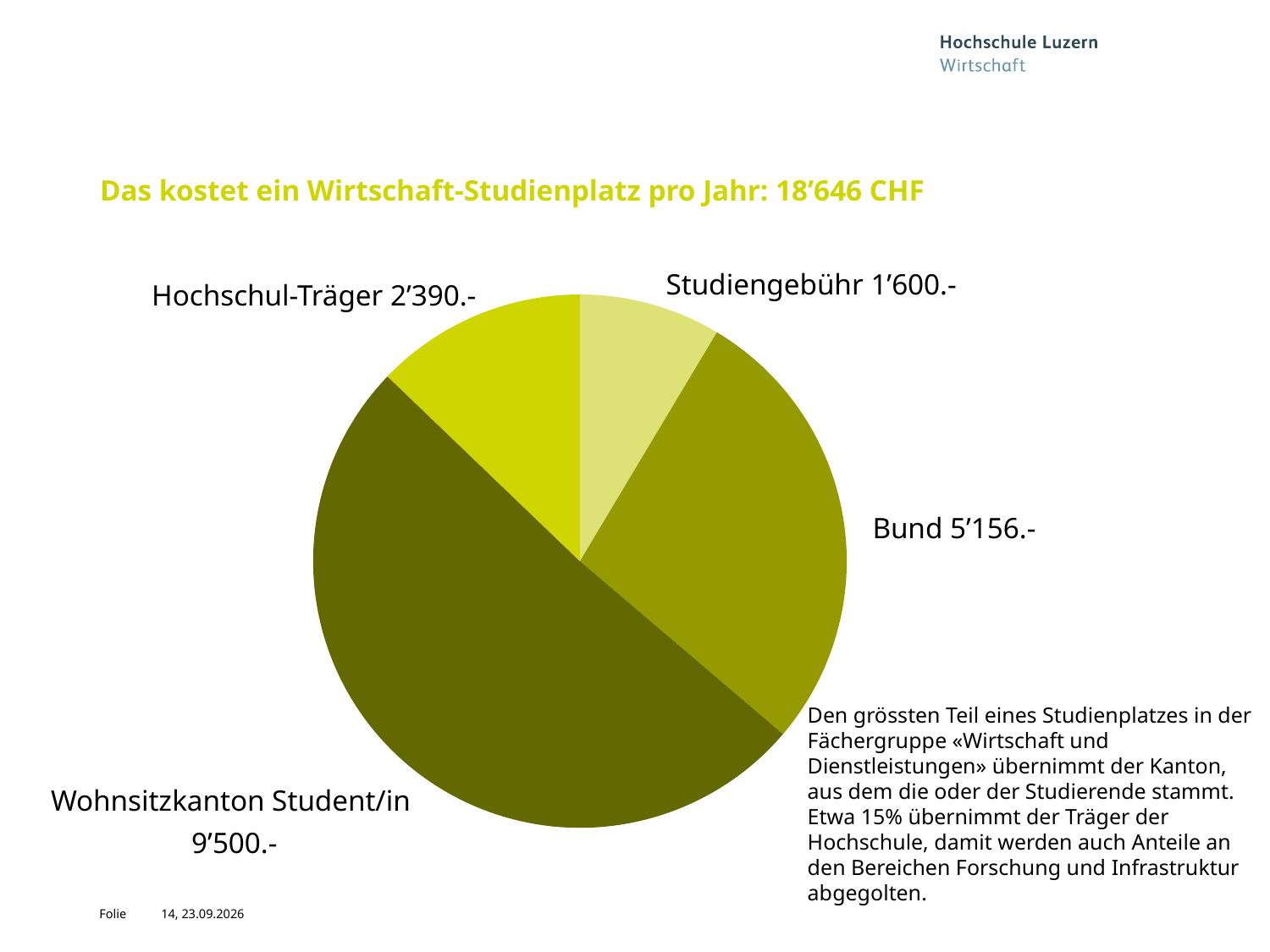
What total cost per year is stated in the chart title? 18'646 CHF What is the value shown for Bund? 5'156.- What is the value shown for Hochschul-Träger? 2'390.- What is the value shown for Wohnsitzkanton Student/in? 9'500.- How many slices does the pie chart have? 4 Which slice of the pie chart is the largest? Wohnsitzkanton Student/in What is the difference between the values for Hochschul-Träger and Studiengebühr? 790.- What is the value shown for Studiengebühr? 1'600.- Which is larger, the value for Bund or the value for Hochschul-Träger? Bund Which slice of the pie chart is the smallest? Studiengebühr What kind of chart is shown on the slide? pie chart What is the difference between the values for Wohnsitzkanton Student/in and Bund? 4'344.-